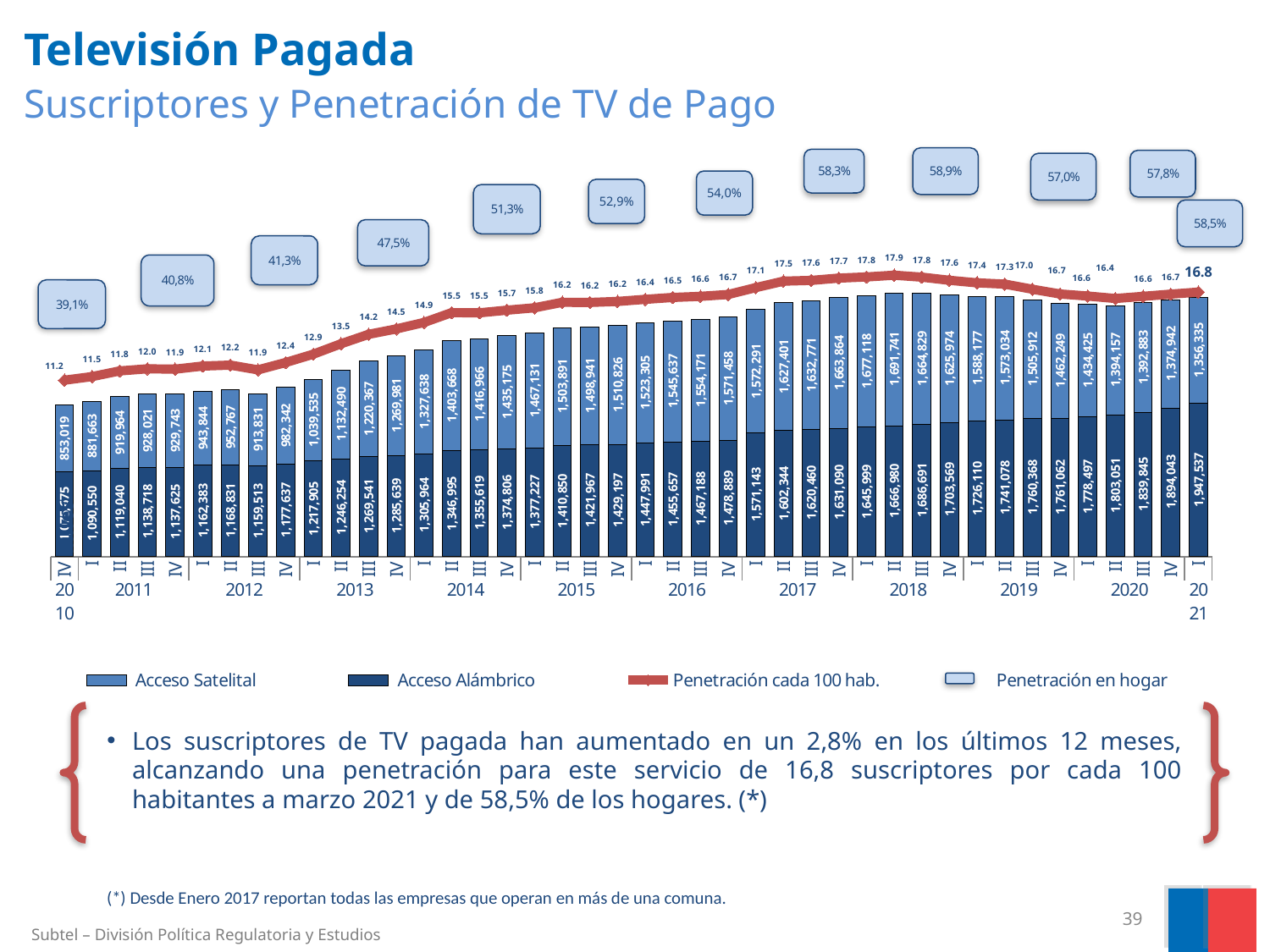
What is the total of Acceso Satelital and Acceso Alámbrico for I 2021? 3,303,872 What is the highest value of the Penetración cada 100 hab. line? 17.9 In which quarter does Acceso Satelital reach its highest value? II 2018 What is the Penetración cada 100 hab. value for I 2021? 16.8 Do the Acceso Alámbrico values rise or fall across the four quarters of 2020? rise What is the Acceso Alámbrico value for I 2021? 1,947,537 What is the difference between the Acceso Alámbrico values for I 2021 and IV 2020? 53,494 In I 2021, which is larger: Acceso Alámbrico or Acceso Satelital? Acceso Alámbrico What is the lowest value of the Penetración cada 100 hab. line? 11.2 What is the Acceso Satelital value for I 2021? 1,356,335 What is the Penetración en hogar value shown for 2018? 58,9% How many series does the legend list? 4